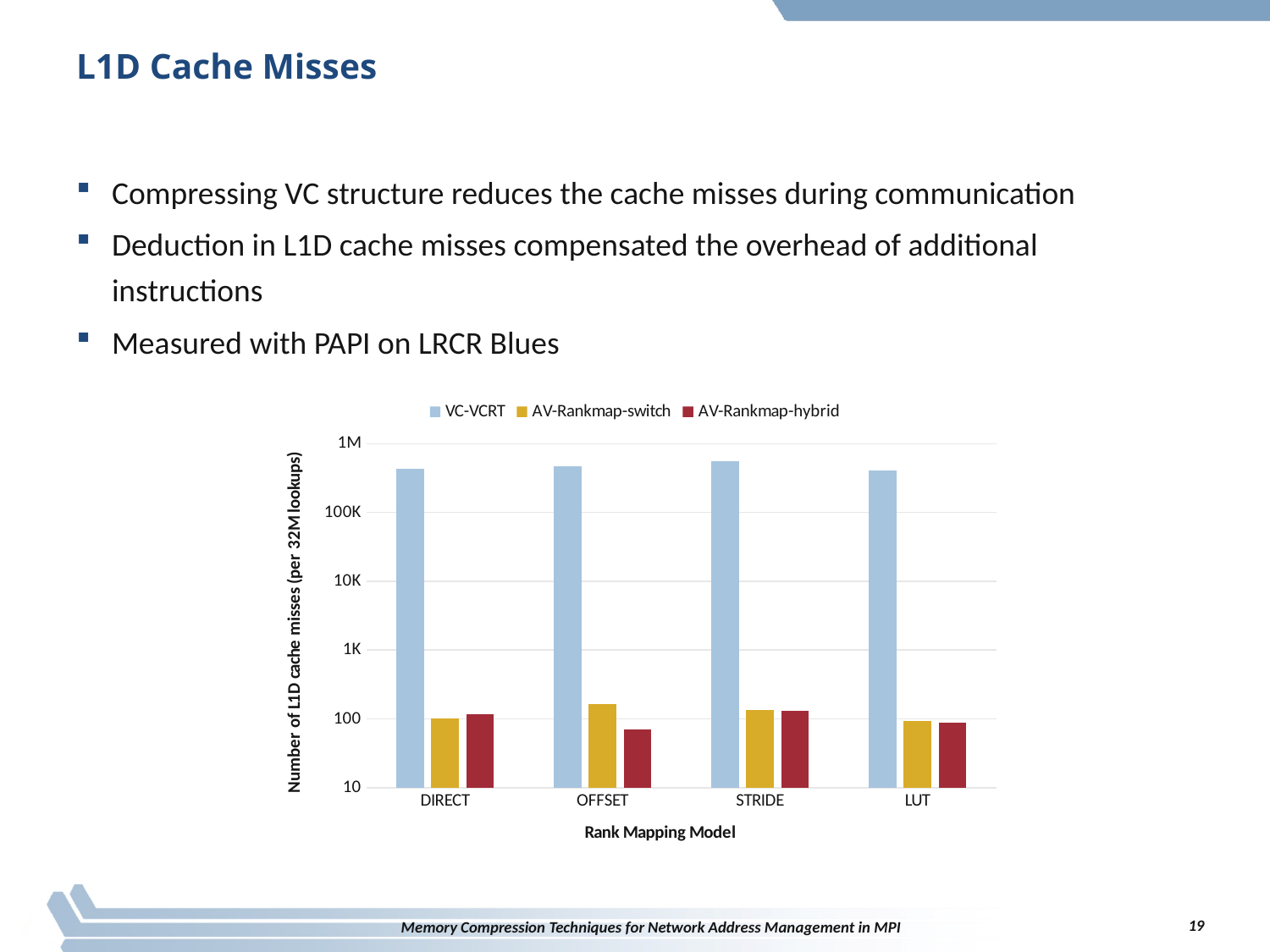
Which rank mapping model has the lowest AV-Rankmap-hybrid value? OFFSET For OFFSET, which is larger: the AV-Rankmap-switch value or the AV-Rankmap-hybrid value? AV-Rankmap-switch Which rank mapping model has the highest AV-Rankmap-switch value? OFFSET Is the AV-Rankmap-hybrid value for OFFSET greater or less than 100? less What is the title of the chart's x axis? Rank Mapping Model What kind of chart is shown on the slide? bar chart Is the VC-VCRT value for DIRECT greater or less than 100K? greater How many series does the chart legend list? 3 Is the VC-VCRT value for STRIDE greater or less than 1M? less How many rank mapping models are shown on the x axis? 4 For DIRECT, which is larger: the VC-VCRT value or the AV-Rankmap-switch value? VC-VCRT